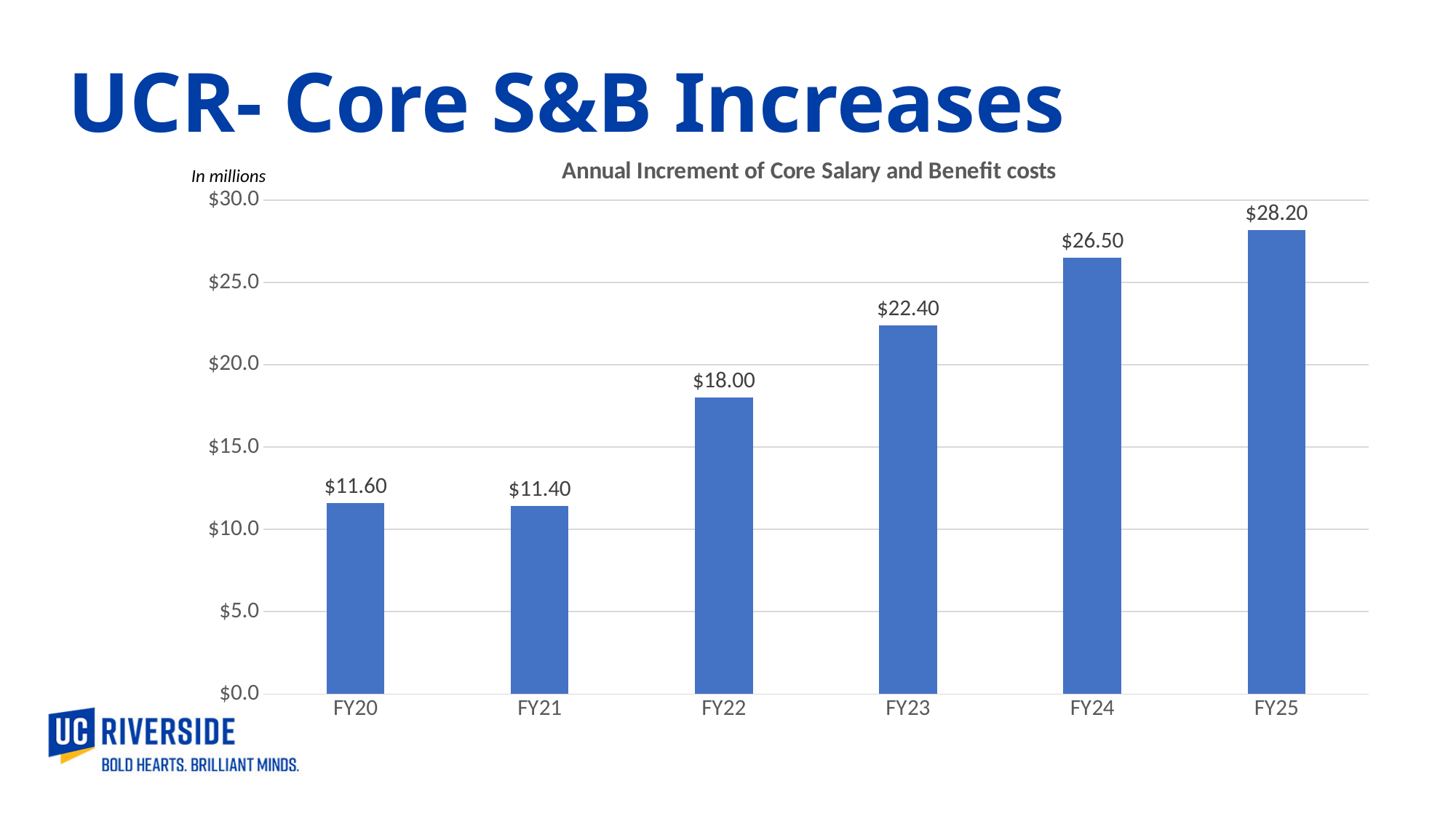
What kind of chart is shown on the slide? bar chart Is the value for FY23 greater or less than $20.0? greater What is the value for FY24? $26.50 Which fiscal year has the highest value? FY25 Which is larger, the value for FY22 or the value for FY23? FY23 Which fiscal year has the lowest value? FY21 What is the value for FY20? $11.60 What is the difference between the FY23 and FY22 values? $4.40 What is the difference between the FY25 and FY24 values? $1.70 What is the title of the chart? Annual Increment of Core Salary and Benefit costs What is the value for FY22? $18.00 How many fiscal years are shown on the x axis? 6